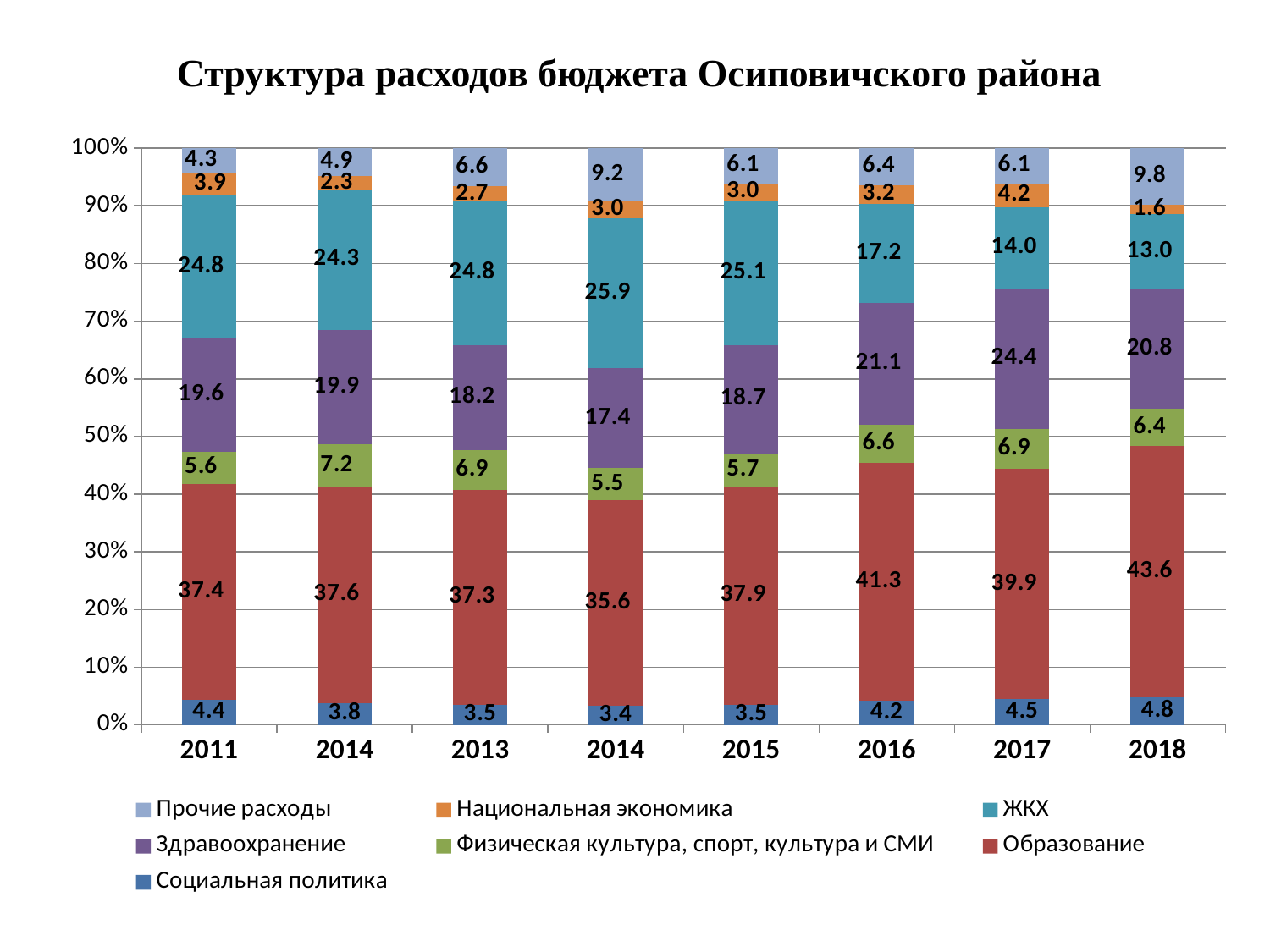
Does the value for ЖКХ rise or fall from 2015 to 2018? Fall What is the difference between the ЖКХ value in 2011 and in 2018? 11.8 What is the value for Образование in 2018? 43.6 What kind of chart is shown on the slide? Stacked bar chart How many bars (year categories) are shown on the x axis? 8 What is the value for ЖКХ in 2011? 24.8 In which year is the value for Образование the highest? 2018 In which year is the value for Национальная экономика the lowest? 2018 How many series does the legend list? 7 What is the value for Социальная политика in 2016? 4.2 Which is larger: the Здравоохранение value in 2016 or in 2017? 2017 What is the value for Здравоохранение in 2017? 24.4